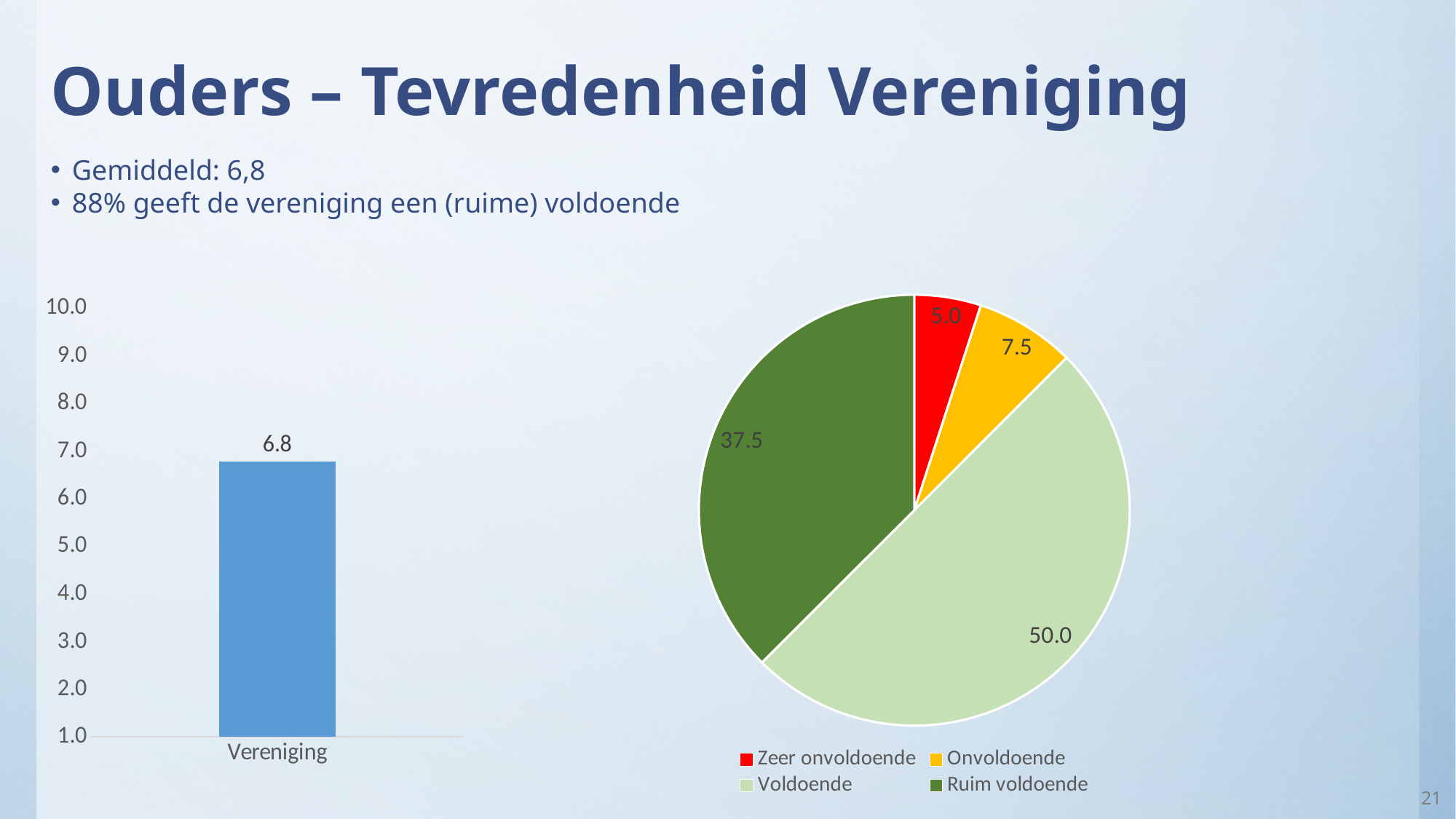
In the pie chart on the right, what is the value for Voldoende? 50.0 In the bar chart on the left, what is the value shown for Vereniging? 6.8 In the bar chart on the left, how many bars are plotted? 1 In the pie chart on the right, what is the value for Zeer onvoldoende? 5.0 What kind of chart is on the right side of the slide? pie chart How many categories does the legend of the pie chart on the right list? 4 In the pie chart on the right, what is the value for Ruim voldoende? 37.5 In the bar chart on the left, is the value for Vereniging greater or less than 7.0? less In the pie chart on the right, which category has the smallest slice? Zeer onvoldoende What kind of chart is on the left side of the slide? bar chart In the pie chart on the right, which category has the largest slice? Voldoende In the pie chart on the right, what is the difference between the values for Voldoende and Ruim voldoende? 12.5